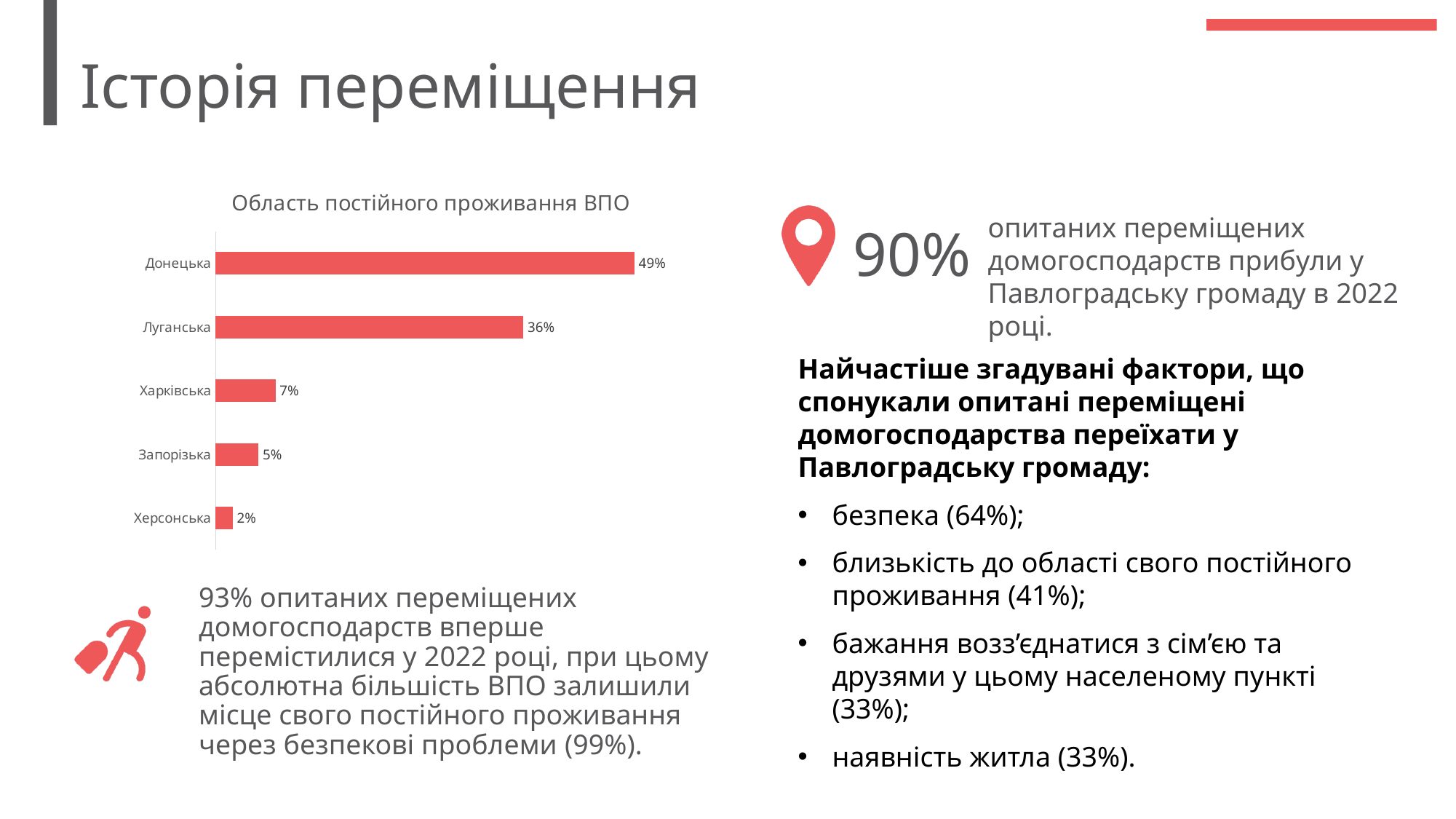
What is the value for Луганська in the chart? 36% Which region has the lowest value in the chart? Херсонська Which region has the highest value in the chart? Донецька What kind of chart is shown on the slide? Bar chart What is the value for Харківська in the chart? 7% What is the difference between the values for Запорізька and Херсонська? 3% What is the value for Херсонська in the chart? 2% Which is larger, the value for Харківська or the value for Запорізька? Харківська What is the value for Донецька in the chart? 49% How many regions are shown in the chart? 5 What is the title of the chart? Область постійного проживання ВПО What is the difference between the values for Донецька and Луганська? 13%